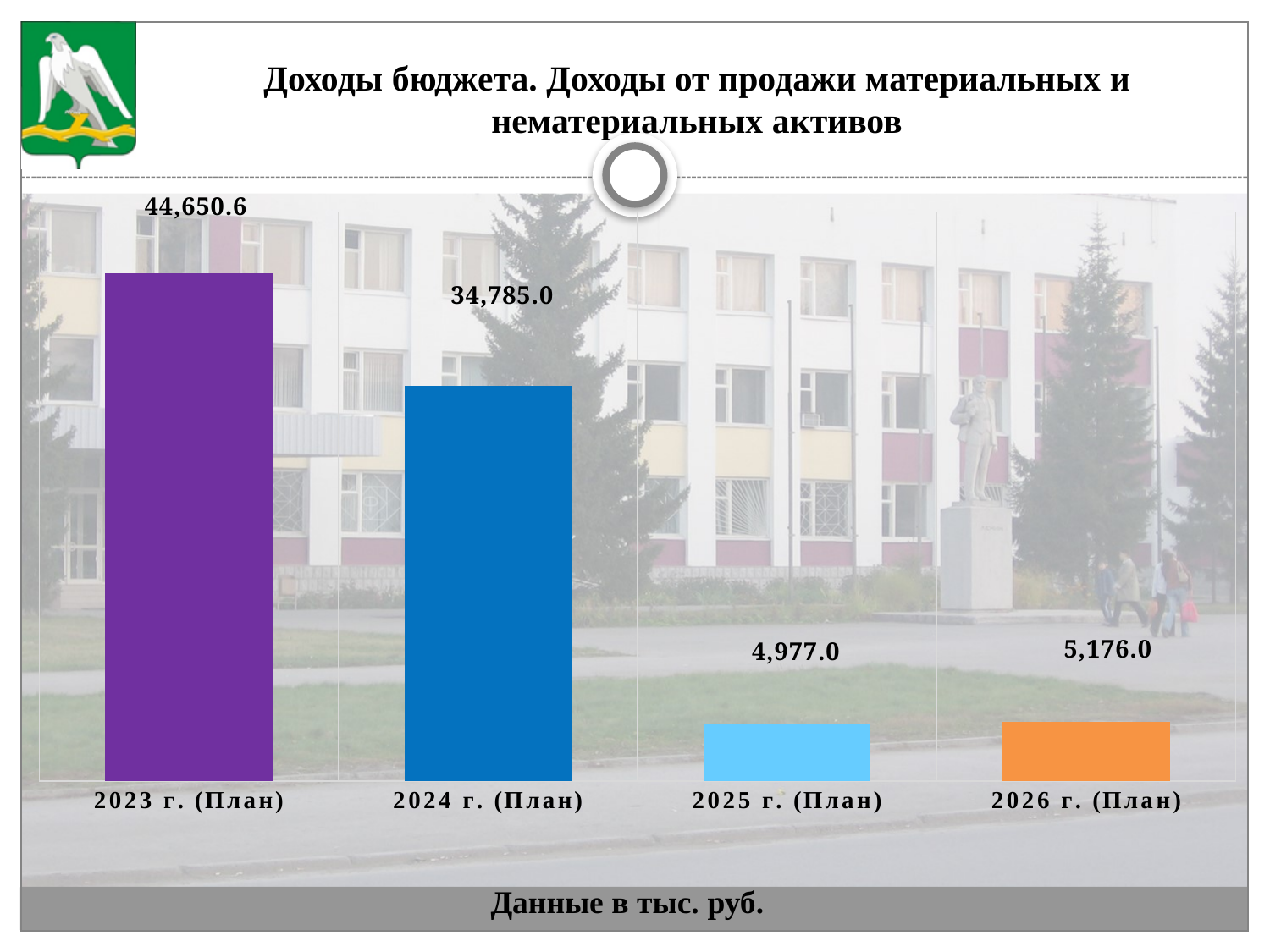
Which is larger, the value for 2024 г. (План) or the value for 2026 г. (План)? 2024 г. (План) What kind of chart is shown on the slide? bar chart What is the value for 2025 г. (План)? 4,977.0 What is the value for 2024 г. (План)? 34,785.0 In what units are the data on the chart given, according to the slide? тыс. руб. What is the difference between the values for 2026 г. (План) and 2025 г. (План)? 199.0 What is the difference between the values for 2023 г. (План) and 2024 г. (План)? 9,865.6 What is the value for 2026 г. (План)? 5,176.0 Which category has the lowest value? 2025 г. (План) Which category has the highest value? 2023 г. (План) How many categories are shown in the chart? 4 What is the value for 2023 г. (План)? 44,650.6